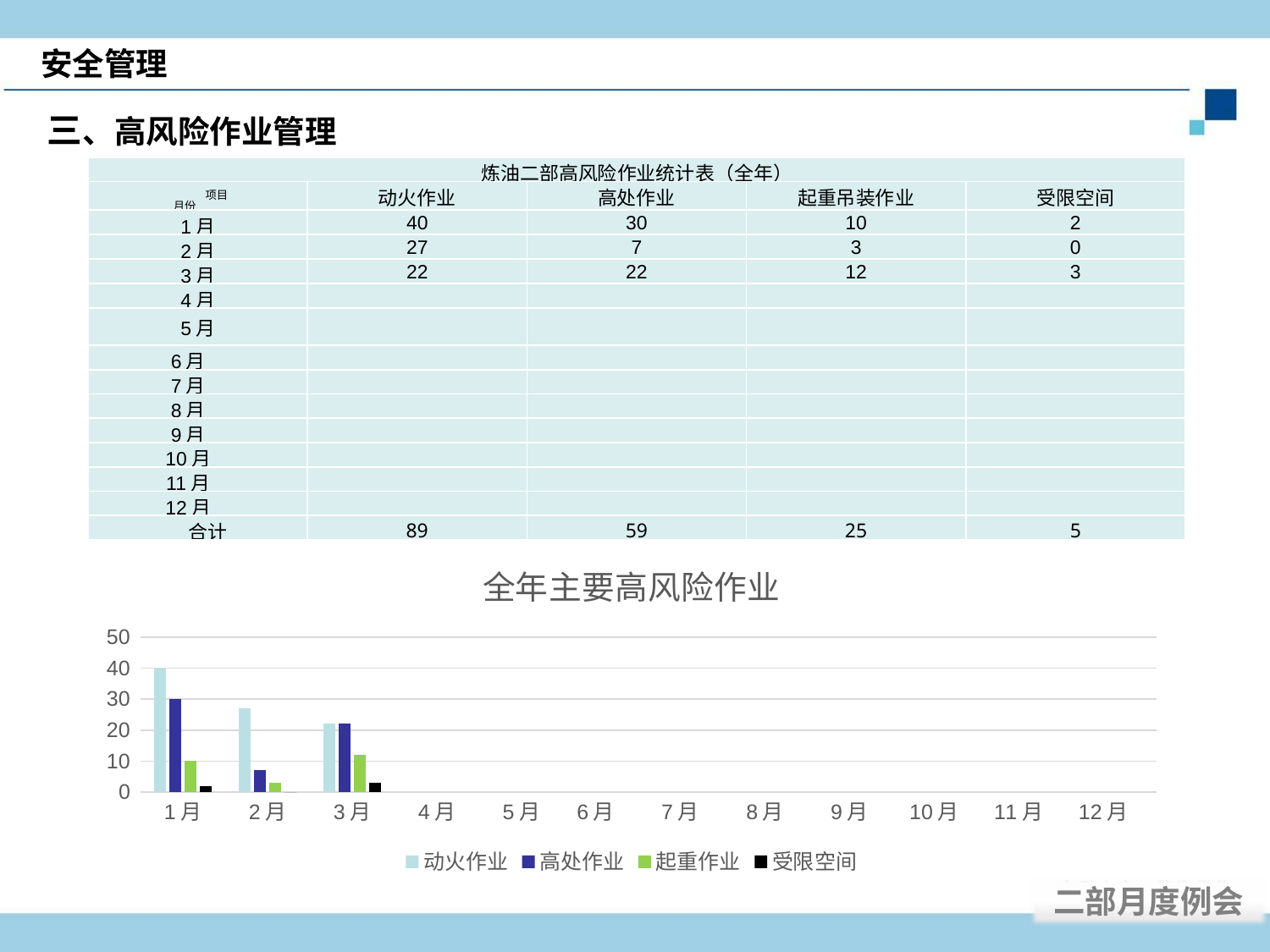
In the 全年主要高风险作业 chart, which series is shown in black in the legend? 受限空间 In the 全年主要高风险作业 chart, is the value for 起重作业 in 3月 greater or less than 20? less In the 全年主要高风险作业 chart, what is the value of 动火作业 for 1月? 40 What kind of chart is shown under the title 全年主要高风险作业? bar chart In the 全年主要高风险作业 chart, what is the difference between 动火作业 and 高处作业 for 1月? 10 In the 全年主要高风险作业 chart, what is the value of 高处作业 for 1月? 30 How many series does the legend of the 全年主要高风险作业 chart list? 4 In the 全年主要高风险作业 chart, do the 动火作业 values rise or fall from 1月 to 3月? fall How many month categories are shown on the x axis of the 全年主要高风险作业 chart? 12 In the 全年主要高风险作业 chart, which month has the highest 动火作业 bar? 1月 In the 全年主要高风险作业 chart, which is larger for 1月: 动火作业 or 高处作业? 动火作业 In the 全年主要高风险作业 chart, is the value for 动火作业 in 2月 greater or less than 20? greater